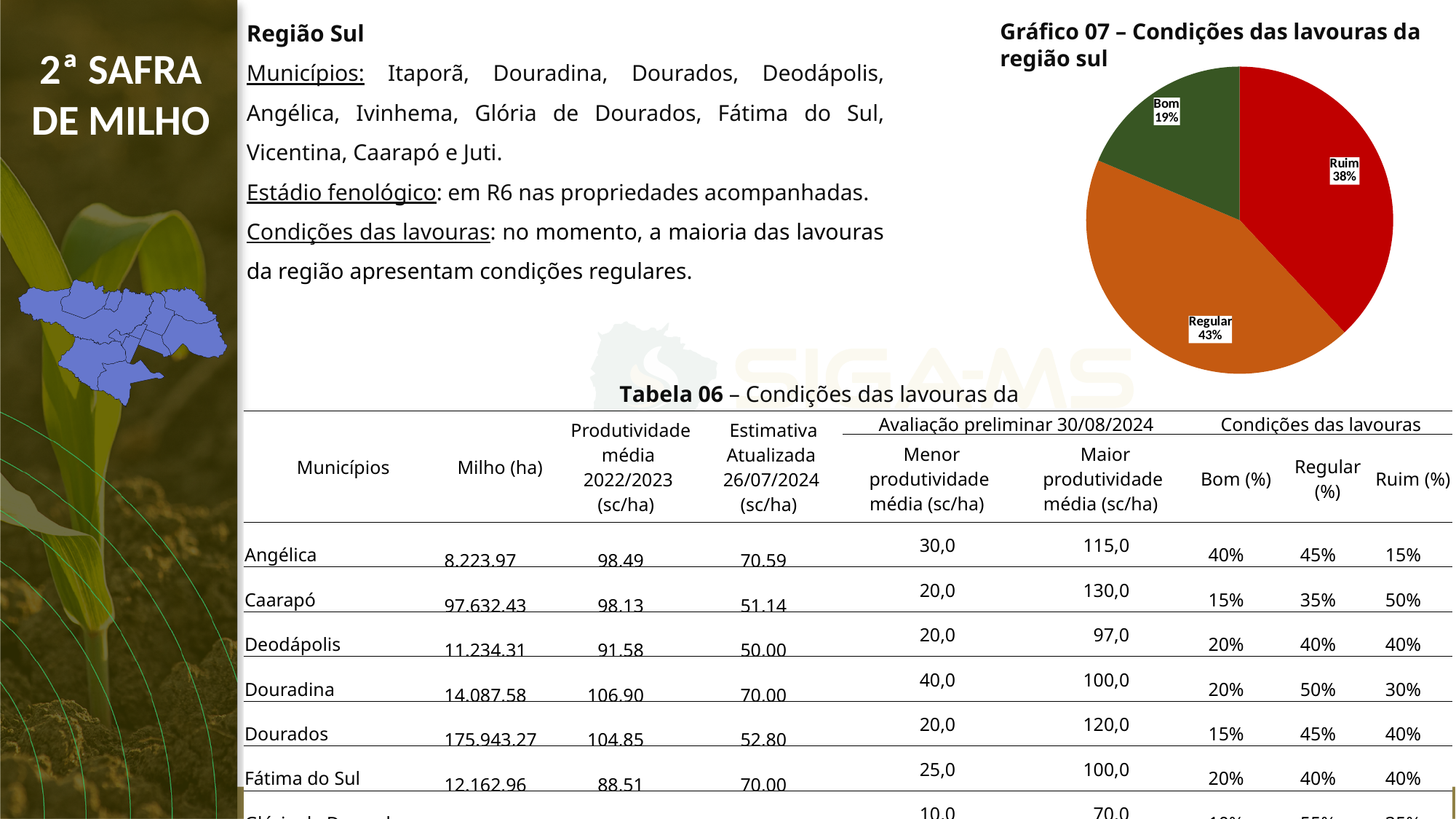
What is the difference in percentage points between the Regular and Ruim slices? 5 Which category has the largest slice in the pie chart? Regular What share of the pie chart does the Regular slice represent? 43% Which category has the smallest slice in the pie chart? Bom What is the difference in percentage points between the Ruim and Bom slices? 19 What type of chart is Gráfico 07? Pie chart What share of the pie chart does the Bom slice represent? 19% How many slices does the pie chart have? 3 What is the title of the pie chart? Gráfico 07 – Condições das lavouras da região sul What colour is the Ruim slice in the pie chart? Red Which slice is larger, Bom or Ruim? Ruim What share of the pie chart does the Ruim slice represent? 38%